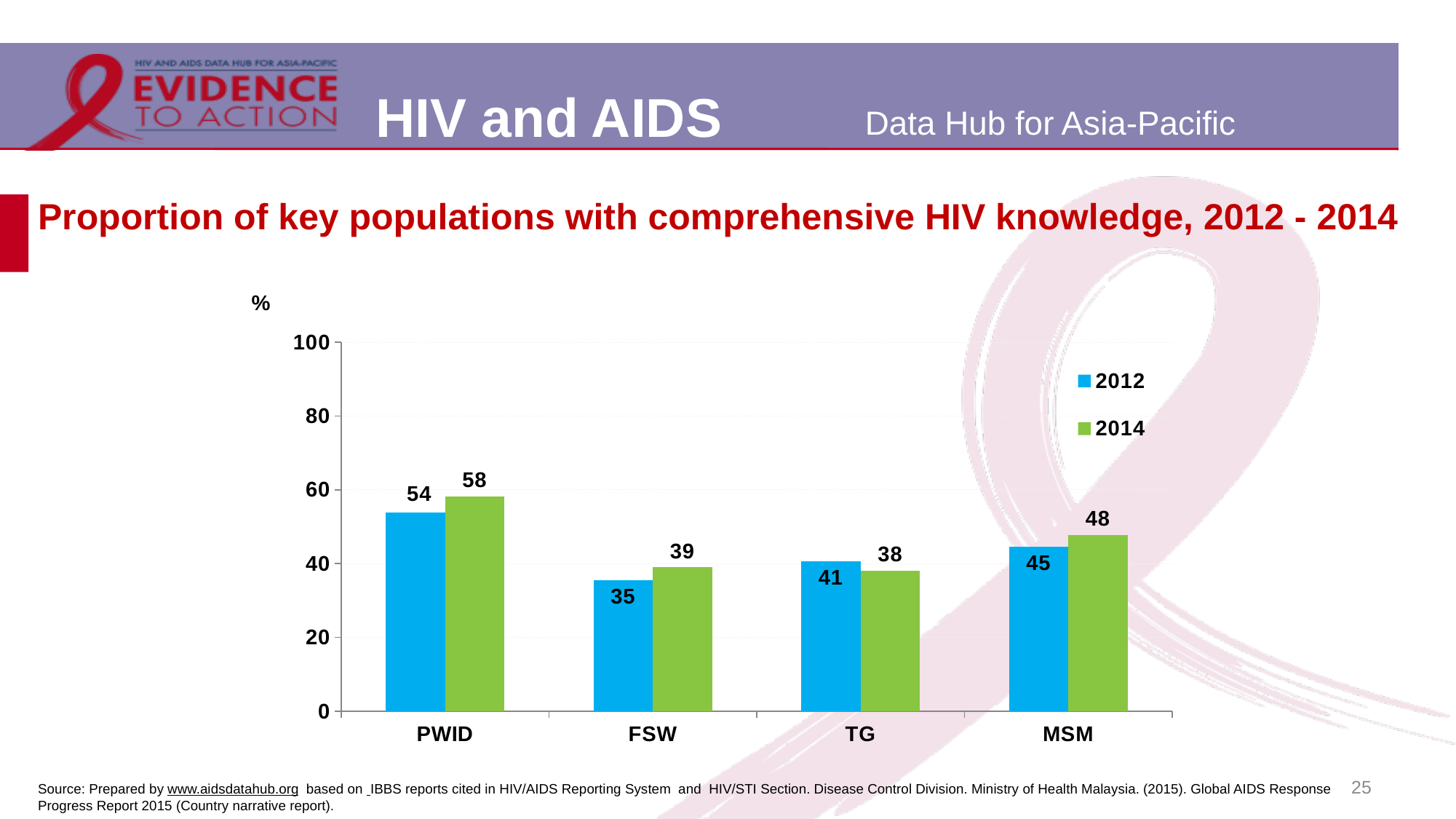
Which colour represents 2014 in the legend? Green Which key population has the highest value in 2014? PWID How many key populations are shown on the x axis? 4 What is the value for MSM in 2014? 48 What is the value for FSW in 2012? 35 Is the value for MSM in 2014 greater or less than 40? greater Which key population has the lowest value in 2012? FSW What kind of chart is shown on the slide? Bar chart Which is larger for TG: the 2012 value or the 2014 value? 2012 How many series does the legend list? 2 What is the difference between the 2014 and 2012 values for PWID? 4 What is the value for PWID in 2012? 54